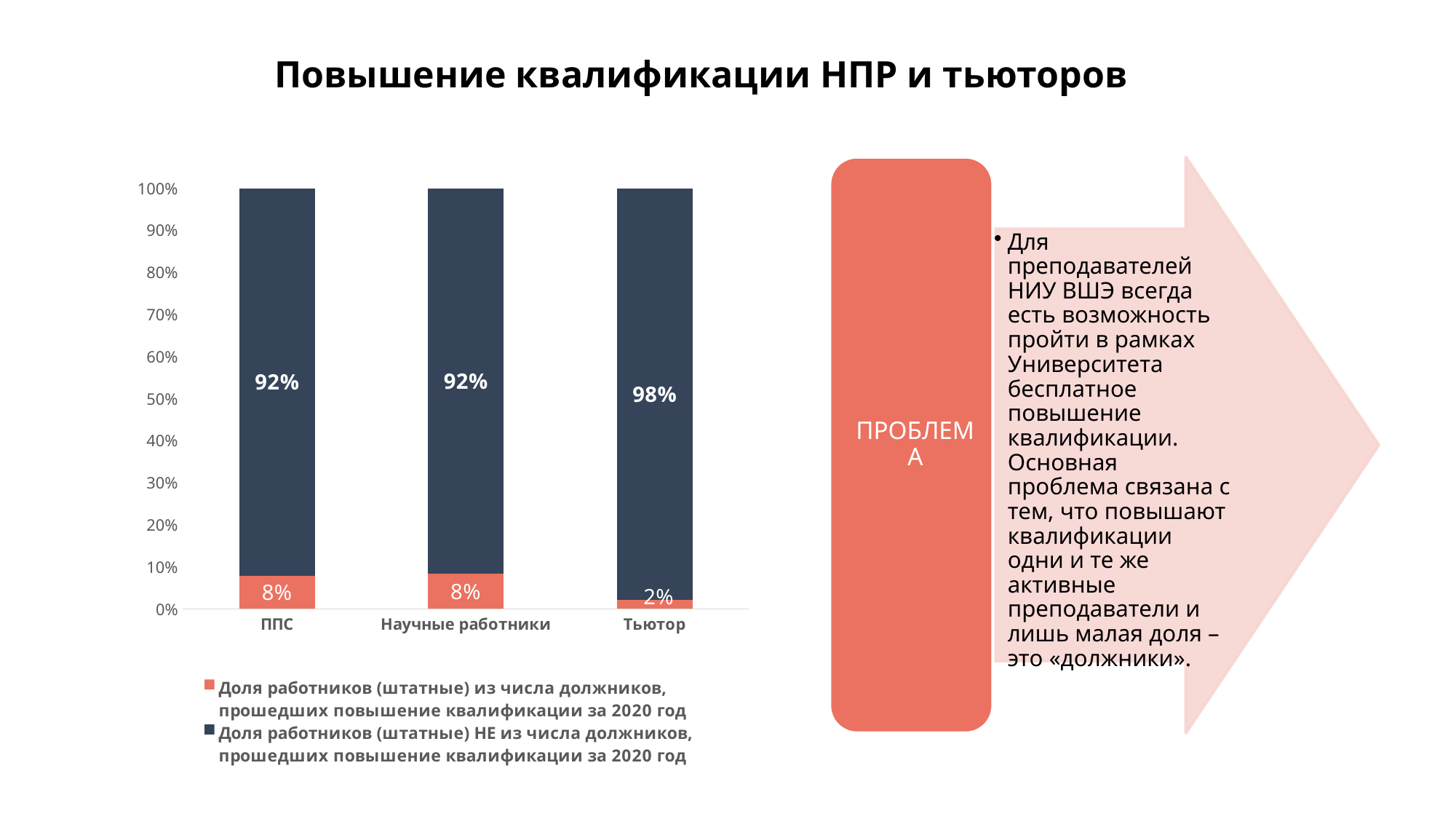
What kind of chart is shown on the slide? stacked bar chart What is the difference between the 'НЕ из числа должников' value for Тьютор and for ППС? 6% How many categories are shown on the x axis of the chart? 3 How many series does the chart legend list? 2 What is the total of the stacked bar for Научные работники? 100% Which category has the highest value in the series 'Доля работников (штатные) НЕ из числа должников, прошедших повышение квалификации за 2020 год'? Тьютор What is the value for Тьютор in the series 'Доля работников (штатные) НЕ из числа должников, прошедших повышение квалификации за 2020 год'? 98% What is the value for Научные работники in the series 'Доля работников (штатные) из числа должников, прошедших повышение квалификации за 2020 год'? 8% Which is larger: the 'из числа должников' value for ППС or for Тьютор? ППС Which category has the lowest value in the series 'Доля работников (штатные) из числа должников, прошедших повышение квалификации за 2020 год'? Тьютор What is the value for ППС in the series 'Доля работников (штатные) из числа должников, прошедших повышение квалификации за 2020 год'? 8% Which colour represents the series 'Доля работников (штатные) из числа должников, прошедших повышение квалификации за 2020 год' in the chart? red (coral)